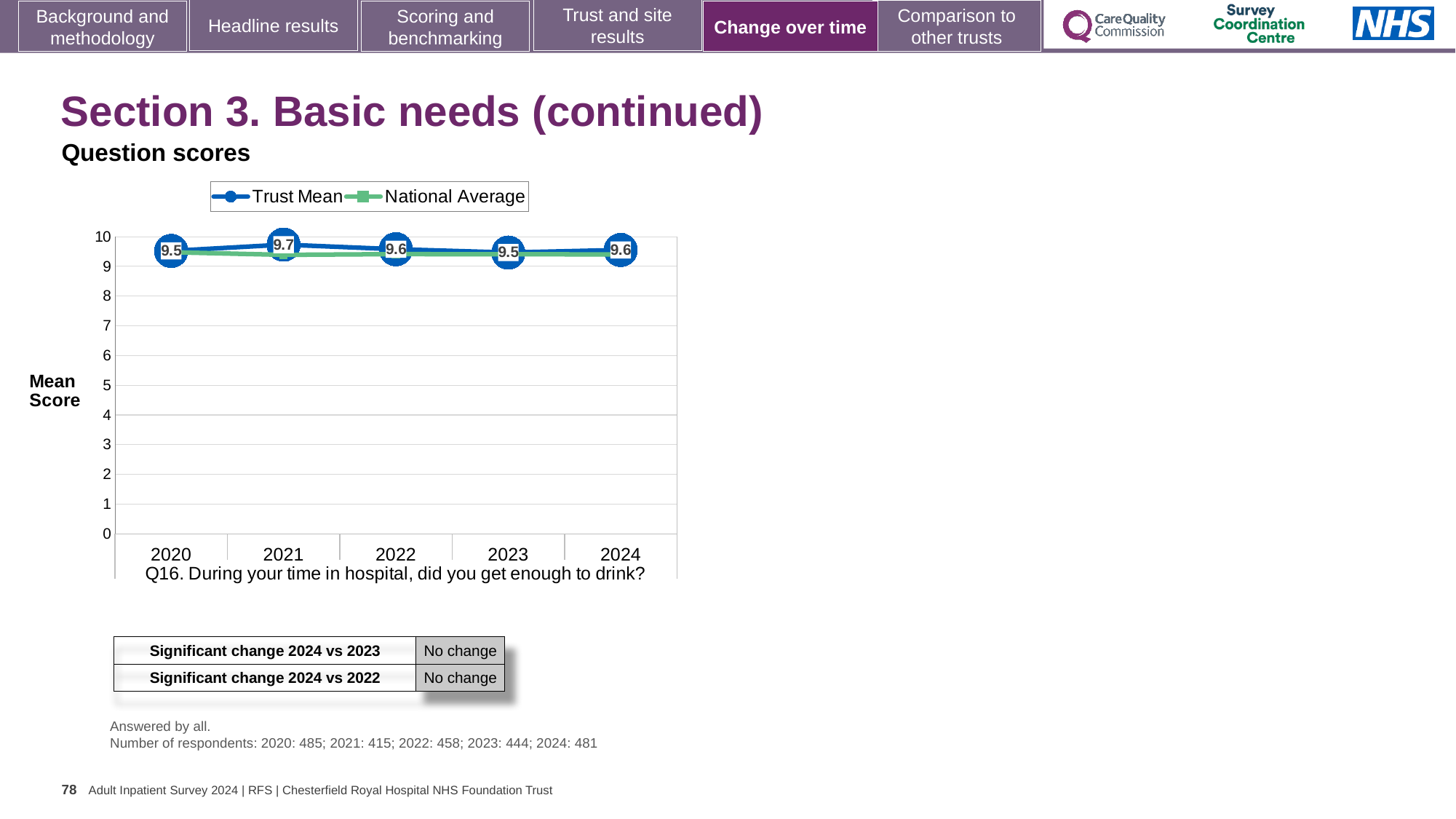
Which year has the larger Trust Mean score, 2021 or 2023? 2021 Is the National Average value for 2024 greater or less than 9? greater What is the Trust Mean score for 2020? 9.5 What is the Trust Mean score for 2024? 9.6 Does the Trust Mean score rise or fall from 2023 to 2024? Rise Which question is the chart about, according to the label below the x axis? Q16. During your time in hospital, did you get enough to drink? What kind of chart is shown on the slide? Line chart In which year is the Trust Mean score highest? 2021 What is the difference between the Trust Mean scores for 2021 and 2020? 0.2 How many years are plotted on the x axis? 5 What is the Trust Mean score for 2021? 9.7 How many series does the legend list? 2